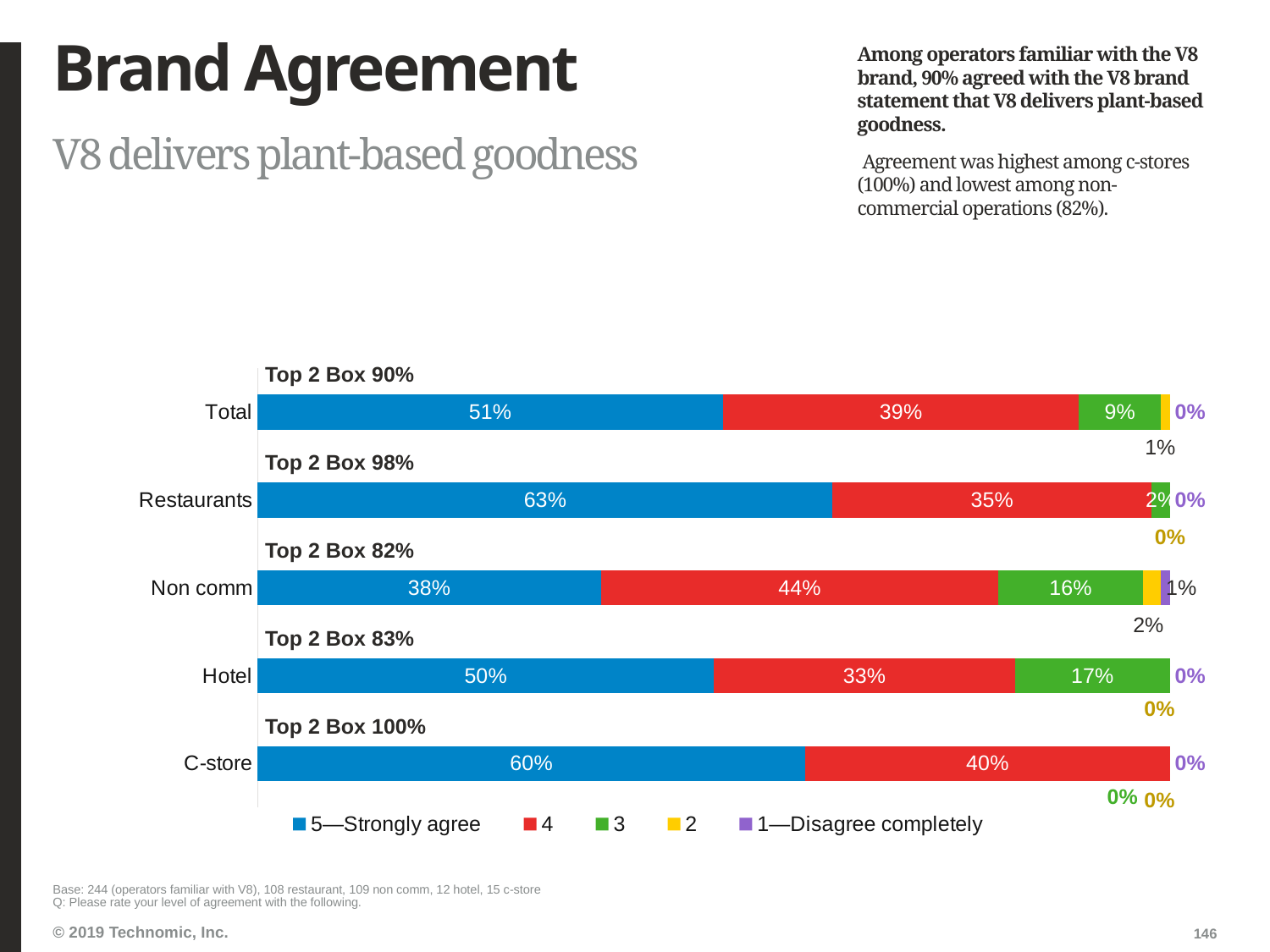
How many series does the legend list? 5 What kind of chart is shown on the slide? Stacked bar chart What is the total of the 5—Strongly agree and '4' segments for Non comm? 82% What is the difference between the 5—Strongly agree values for C-store and Total? 9% What percentage of Restaurants respondents selected 5—Strongly agree? 63% How many categories are shown on the y axis of the chart? 5 What is the Top 2 Box value shown for C-store? 100% What is the value for the '4' series for Non comm? 44% Which is larger: the '4' value for C-store or the '4' value for Hotel? C-store Which category has the lowest value for 5—Strongly agree? Non comm Which category has the highest value for 5—Strongly agree? Restaurants What is the value for the '3' series for Hotel? 17%